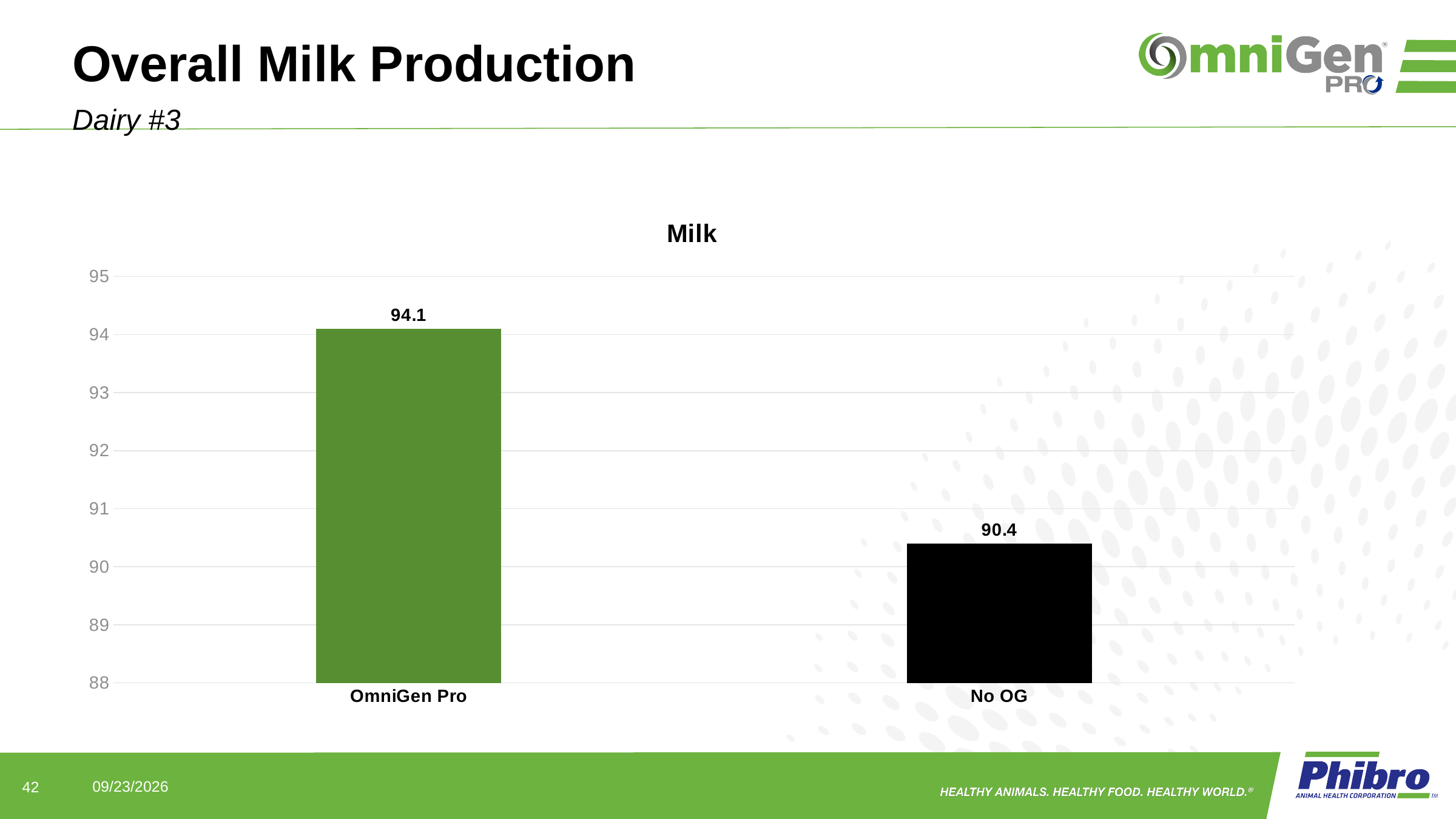
Which is larger, the value for OmniGen Pro or the value for No OG? OmniGen Pro What is the value for OmniGen Pro? 94.1 What colour is the bar for OmniGen Pro? green Is the value for No OG greater or less than 91? less Which category has the highest value? OmniGen Pro What kind of chart is shown on the slide? bar chart What is the difference between the OmniGen Pro and No OG values? 3.7 What is the title of the chart? Milk What is the value for No OG? 90.4 Which category has the lowest value? No OG How many categories are shown in the chart? 2 Is the value for OmniGen Pro greater or less than 93? greater